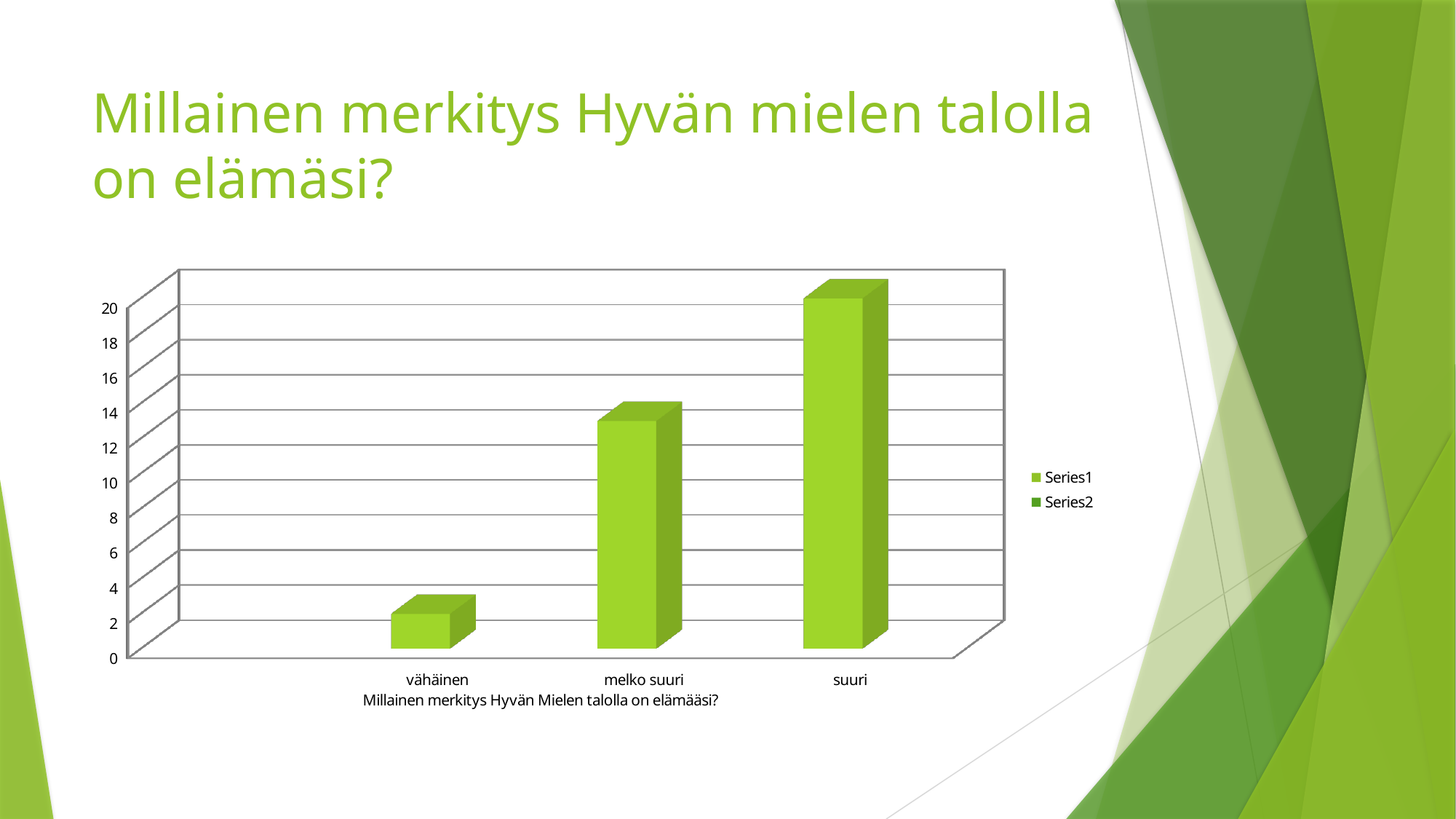
How many categories are shown on the x axis of the chart? 3 Is the value for suuri greater or less than 16? greater Is the value for melko suuri greater or less than 10? greater How many series does the chart's legend list? 2 Which is larger, the value for melko suuri or the value for vähäinen? melko suuri Which category has the highest bar? suuri Which category has the lowest bar? vähäinen Is the value for melko suuri greater or less than 16? less What is the title printed below the x axis of the chart? Millainen merkitys Hyvän Mielen talolla on elämääsi? Do the bar values rise or fall from left to right along the x axis? rise What kind of chart is shown on the slide? bar chart